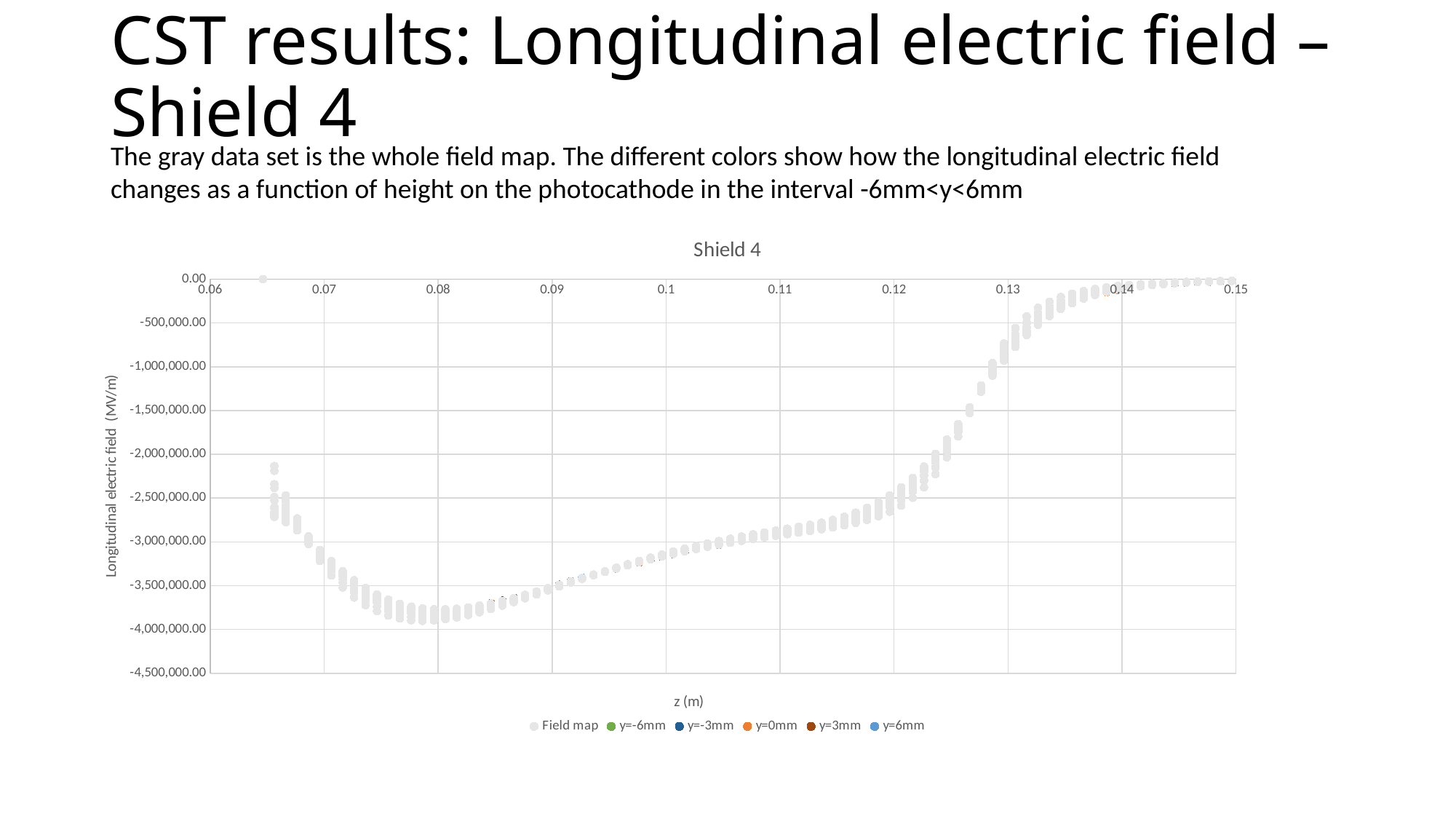
Between z = 0.065 and z = 0.078, do the Field map values rise or fall as z increases? fall Between z = 0.08 and z = 0.15, do the Field map values rise or fall as z increases? rise Which is larger, the Field map value at z = 0.13 or at z = 0.08? z = 0.13 Which is larger, the Field map value at z = 0.1 or at z = 0.14? z = 0.14 How many series does the legend of the Shield 4 chart list? 6 Is the Field map value at z = 0.14 greater or less than -500,000.00? greater What kind of chart is shown on the slide? scatter chart Is the Field map value at z = 0.12 greater or less than -3,000,000.00? greater What is the title of the chart? Shield 4 Is the Field map value at z = 0.08 greater or less than -3,500,000.00? less What is the label of the x axis of the chart? z (m)